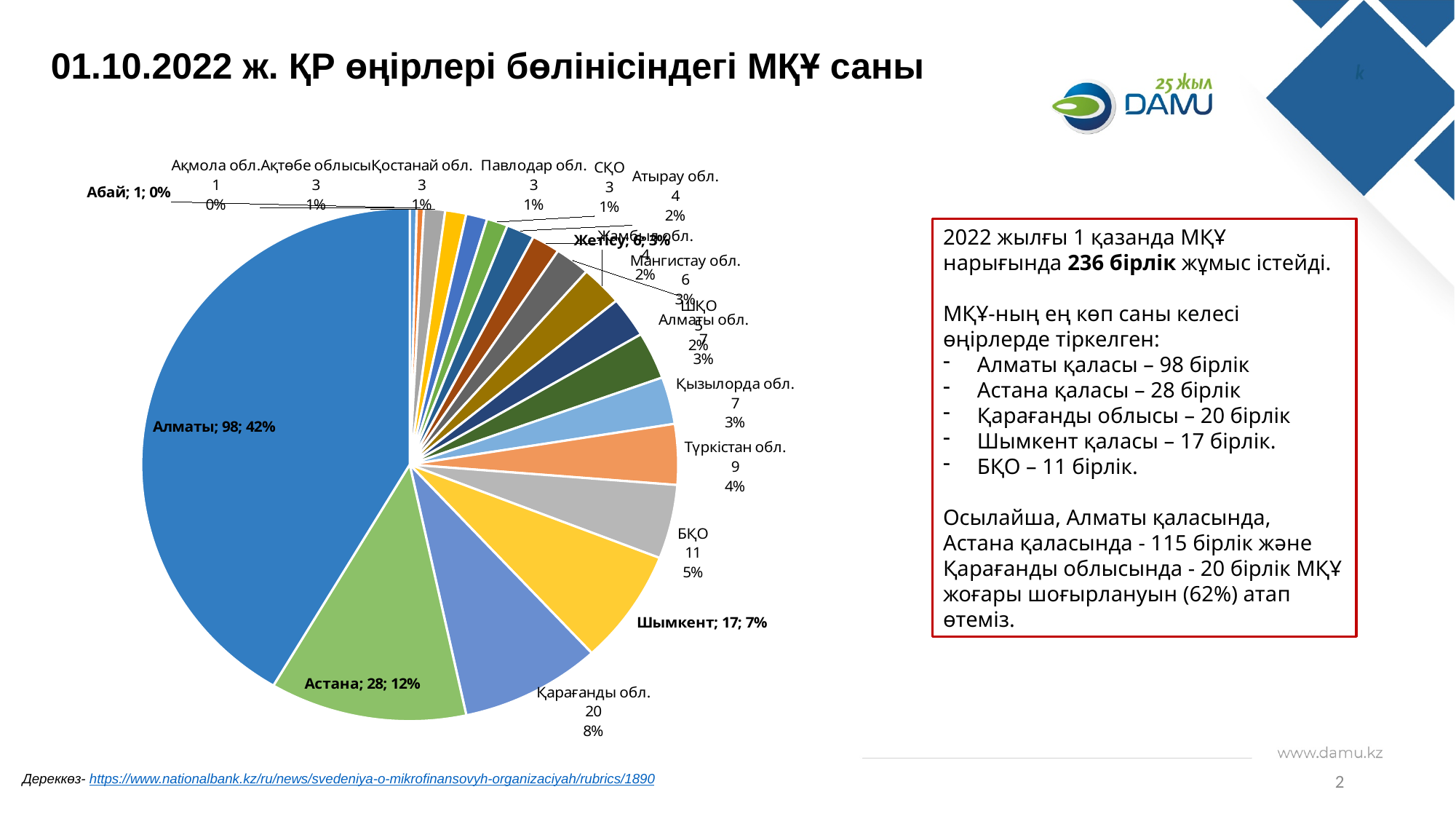
What share of the pie does Алматы account for? 42% What value is shown for Қарағанды обл. in the pie chart? 20 What is the difference between the values for Алматы and Астана? 70 What type of chart is shown on the slide? pie chart What share of the pie does Шымкент account for? 7% What value is shown for Түркістан обл. in the pie chart? 9 What value is shown for Астана in the pie chart? 28 Which is larger, the value for Қарағанды обл. or the value for Шымкент? Қарағанды обл. Which region has the largest slice in the pie chart? Алматы How many units are shown for Алматы in the pie chart? 98 What value is shown for БҚО in the pie chart? 11 What value is shown for Шымкент in the pie chart? 17